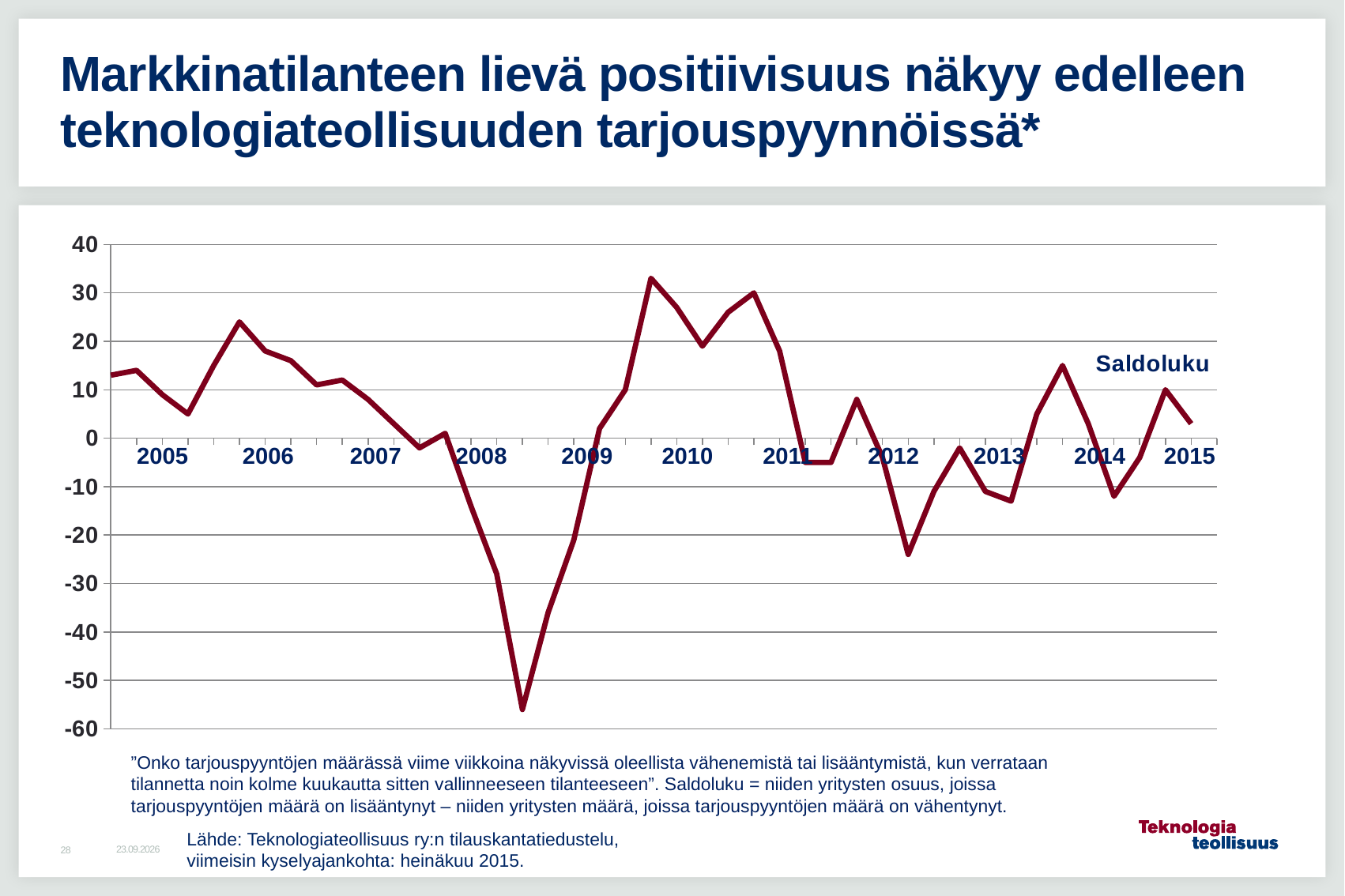
What kind of chart is shown on the slide? line chart What is the name of the series plotted on the chart? Saldoluku How many series are plotted on the chart? 1 Is the lowest value of the line in 2012 greater or less than -20? less How many year labels are shown on the x axis? 11 Is the last plotted value, in 2015, greater or less than 0? greater In which year does the line reach its lowest point? 2009 What are the minimum and maximum values shown on the y axis? -60 and 40 Which is larger: the value at the start of 2005 or the final value in 2015? the value at the start of 2005